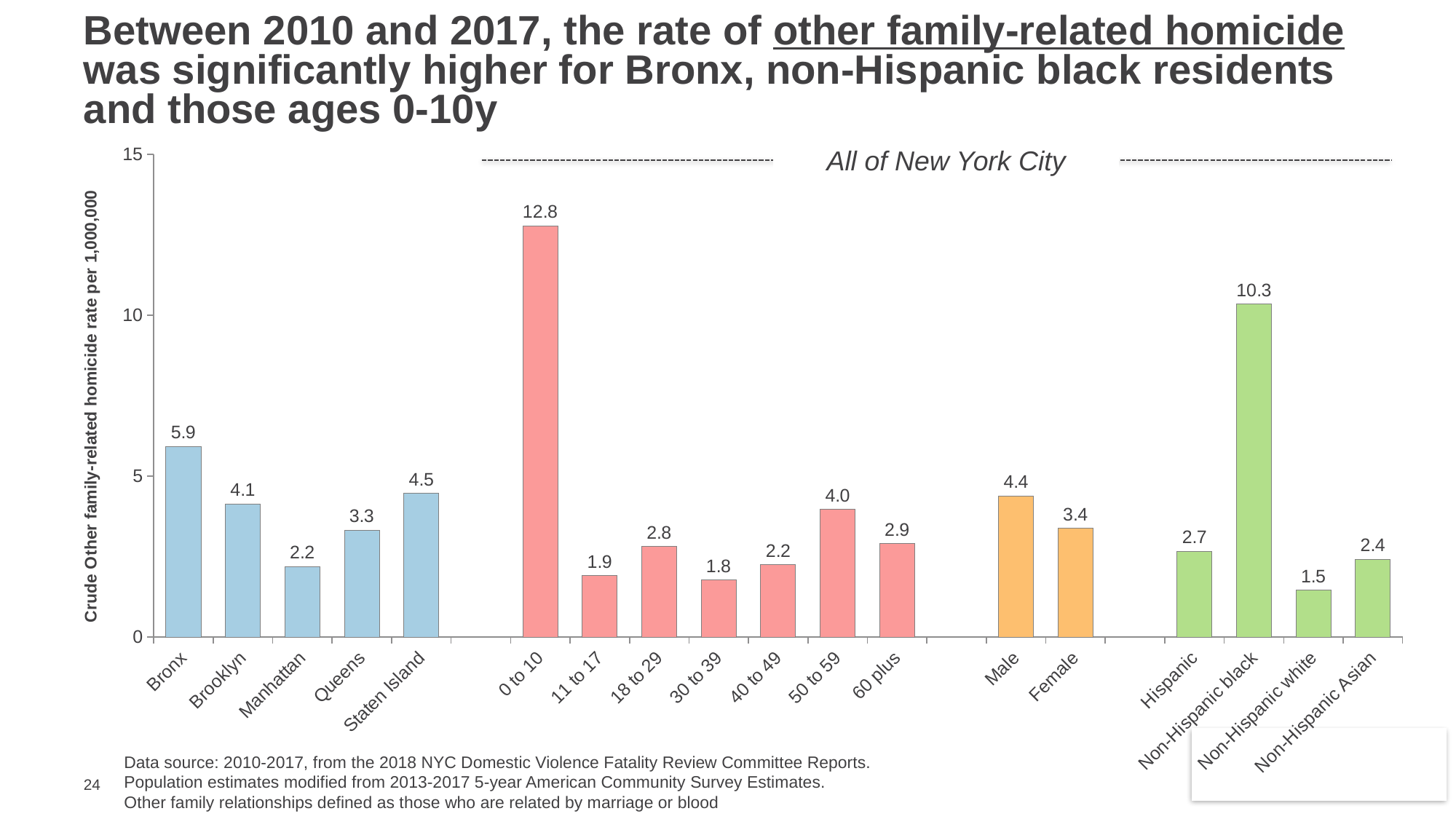
Which borough has the lowest other family-related homicide rate? Manhattan What kind of chart is shown on the slide? Bar chart What is the difference between the rates for Male and Female? 1.0 Which has a higher rate, Queens or Brooklyn? Brooklyn What is the difference between the rates for the Bronx and Staten Island? 1.4 What is the value shown for the 0 to 10 age group? 12.8 What is the value shown for Non-Hispanic black residents? 10.3 How many age group categories are plotted on the chart? 7 What is the crude other family-related homicide rate per 1,000,000 for the Bronx? 5.9 Which race/ethnicity group has the lowest rate? Non-Hispanic white What is the value shown for Female? 3.4 Which age group has the highest other family-related homicide rate? 0 to 10